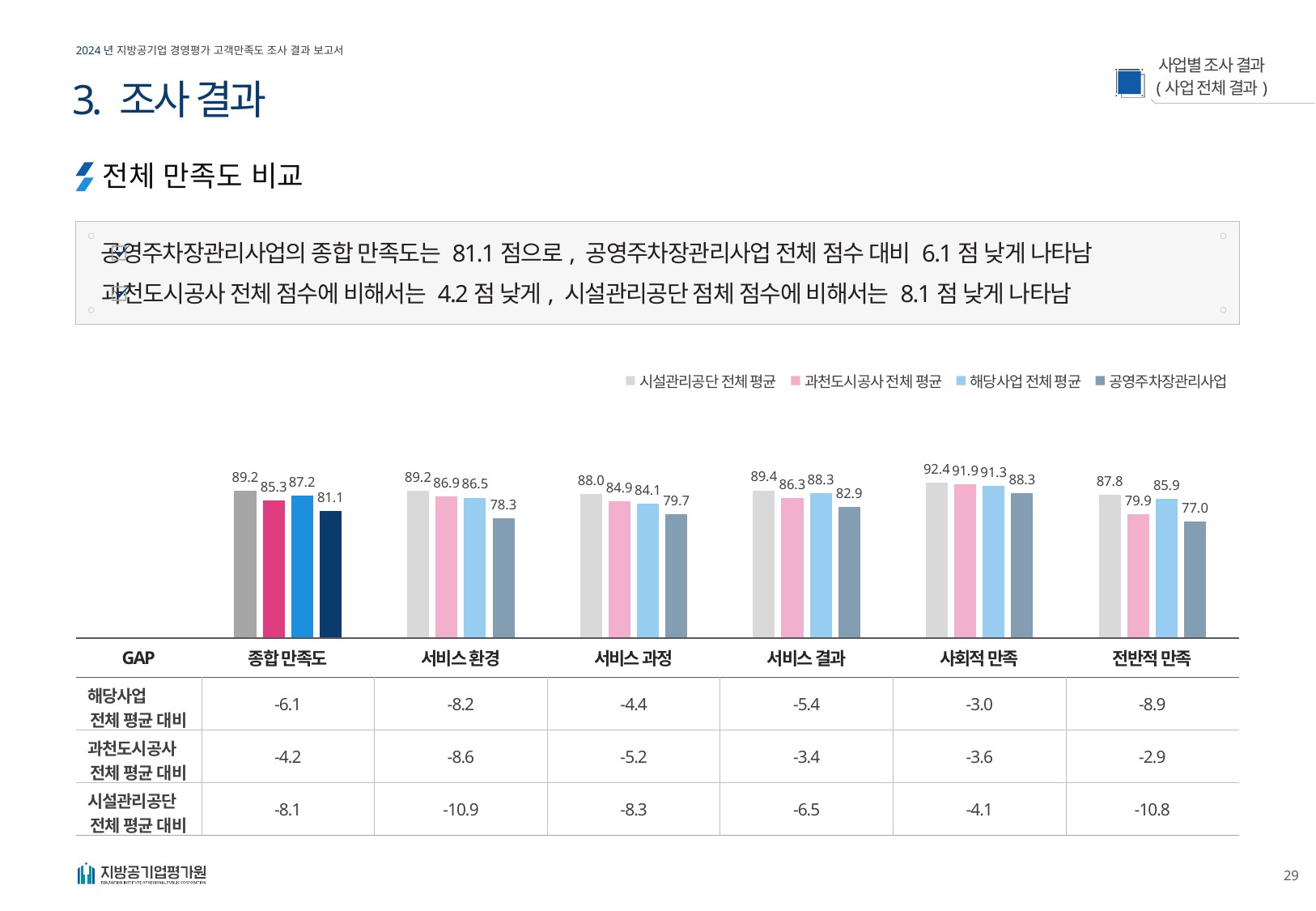
What is the value for 시설관리공단 전체 평균 in the 사회적 만족 category? 92.4 In which category does 공영주차장관리사업 have its lowest value? 전반적 만족 What is the value for 과천도시공사 전체 평균 in the 전반적 만족 category? 79.9 What is the difference between 시설관리공단 전체 평균 and 공영주차장관리사업 in the 서비스 환경 category? 10.9 In which category does 공영주차장관리사업 have its highest value? 사회적 만족 What is the value for 해당사업 전체 평균 in the 서비스 과정 category? 84.1 What is the value for 공영주차장관리사업 in the 종합 만족도 category? 81.1 Which series is shown in pink in the chart legend? 과천도시공사 전체 평균 How many series does the chart legend list? 4 How many categories are shown on the x axis of the chart? 6 Which is larger in the 서비스 결과 category: 과천도시공사 전체 평균 or 해당사업 전체 평균? 해당사업 전체 평균 What kind of chart is shown on the slide? Bar chart